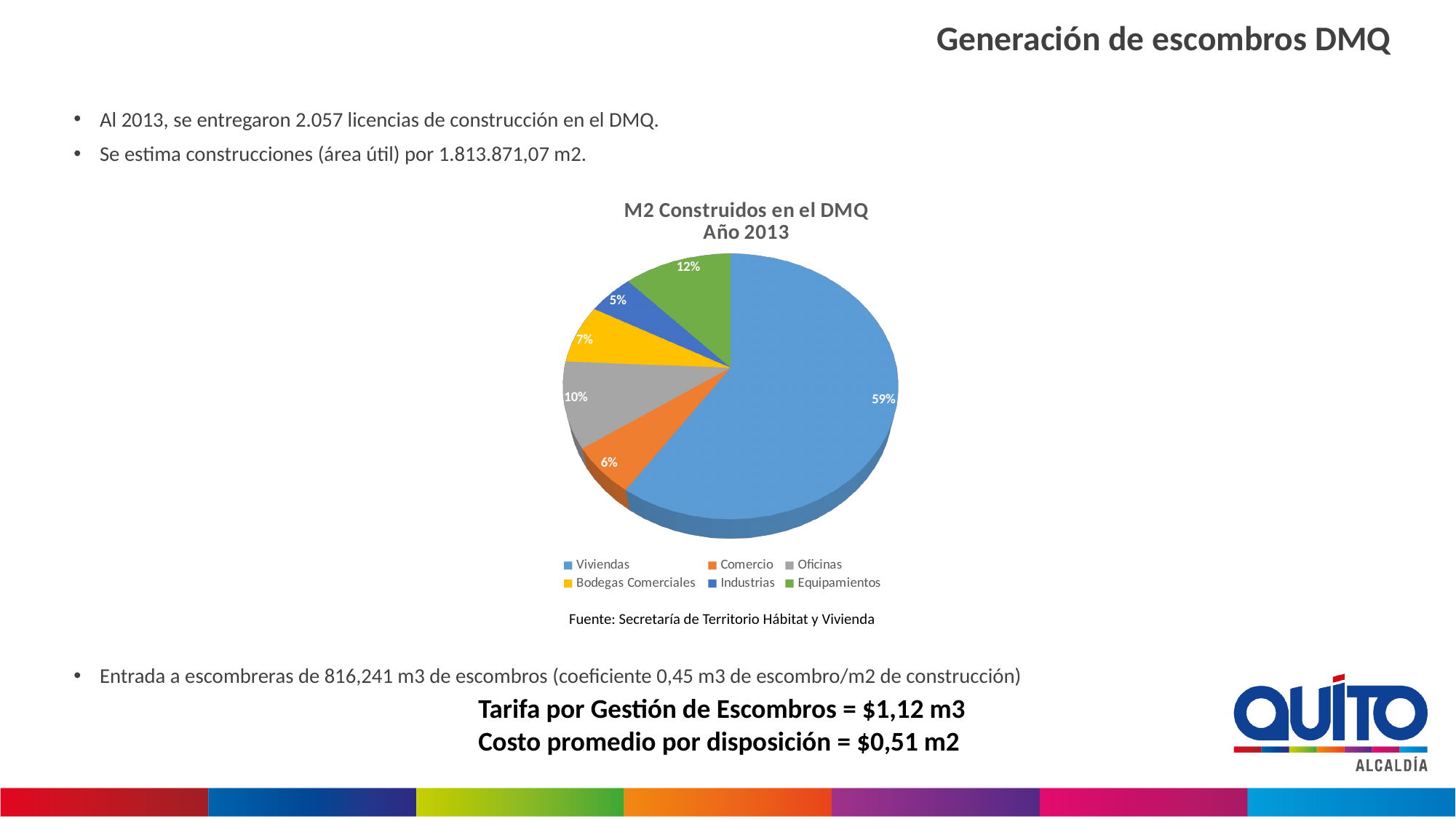
How many categories does the legend list? 6 What is the title of the chart? M2 Construidos en el DMQ Año 2013 What is the difference between the shares of Viviendas and Equipamientos? 47% Which category has the largest share of the pie? Viviendas Which is larger, the share for Oficinas or the share for Comercio? Oficinas What is the value for Bodegas Comerciales? 7% Which category has the smallest share of the pie? Industrias What share of the pie does Equipamientos represent? 12% What share of the pie does Oficinas represent? 10% What type of chart is shown on the slide? Pie chart What share of the pie does Viviendas represent? 59% What is the value for Industrias? 5%